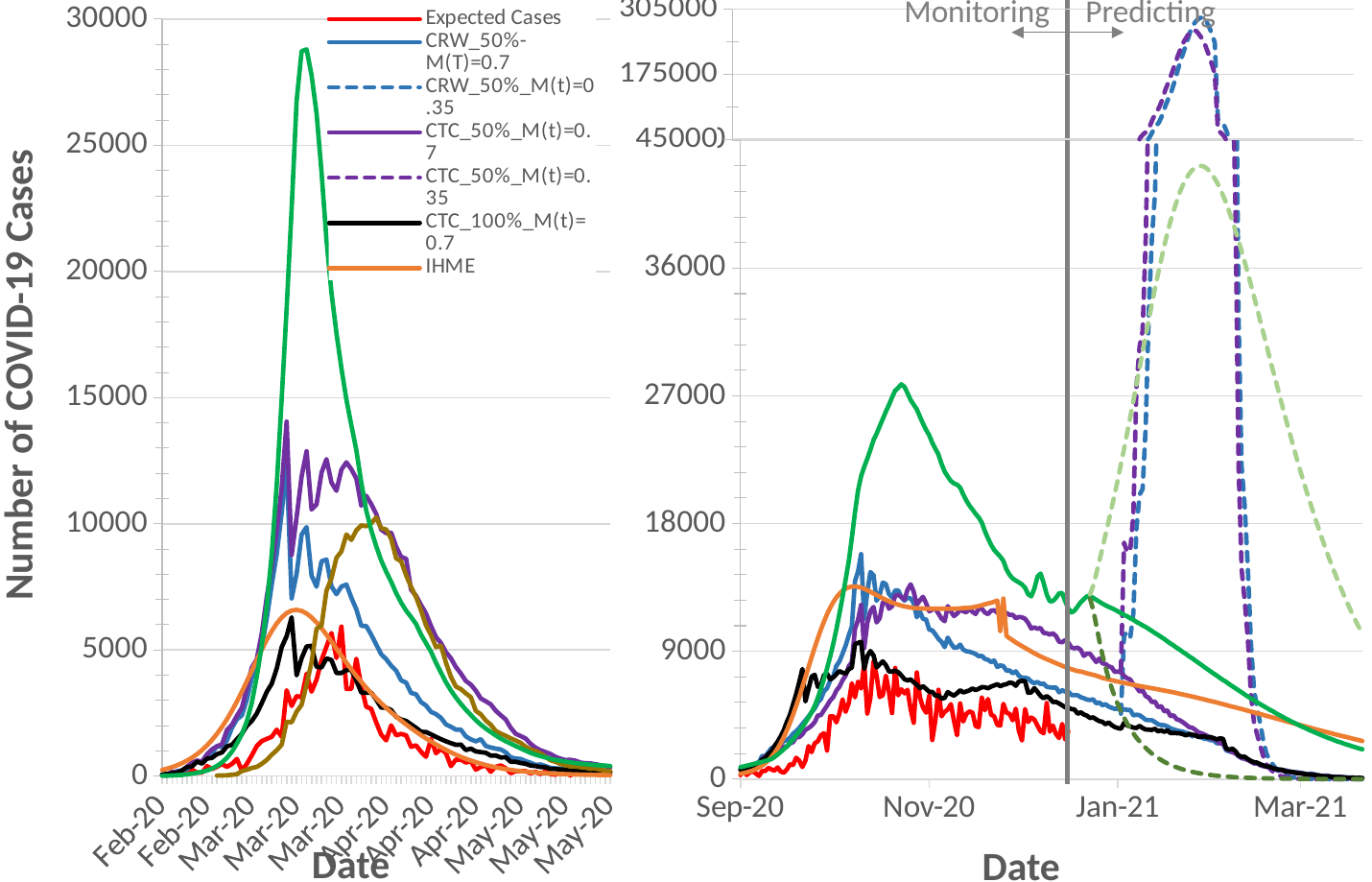
On the left chart, is the peak value of the IHME (orange) line greater or less than 10000? less On the left chart, is the peak value of the green line greater or less than 25000? greater On the left chart, which line reaches a higher peak, the green line or the solid purple CTC_50%_M(t)=0.7 line? the green line On the left chart, is the peak value of the Expected Cases (red) line greater or less than 10000? less How many series does the legend on the left chart list? 7 What type of chart is the left chart? line chart On the right chart, does the solid green line rise or fall across the Predicting region? fall What is the y-axis title of the left chart? Number of COVID-19 Cases What two phase labels appear at the top of the right chart? Monitoring and Predicting